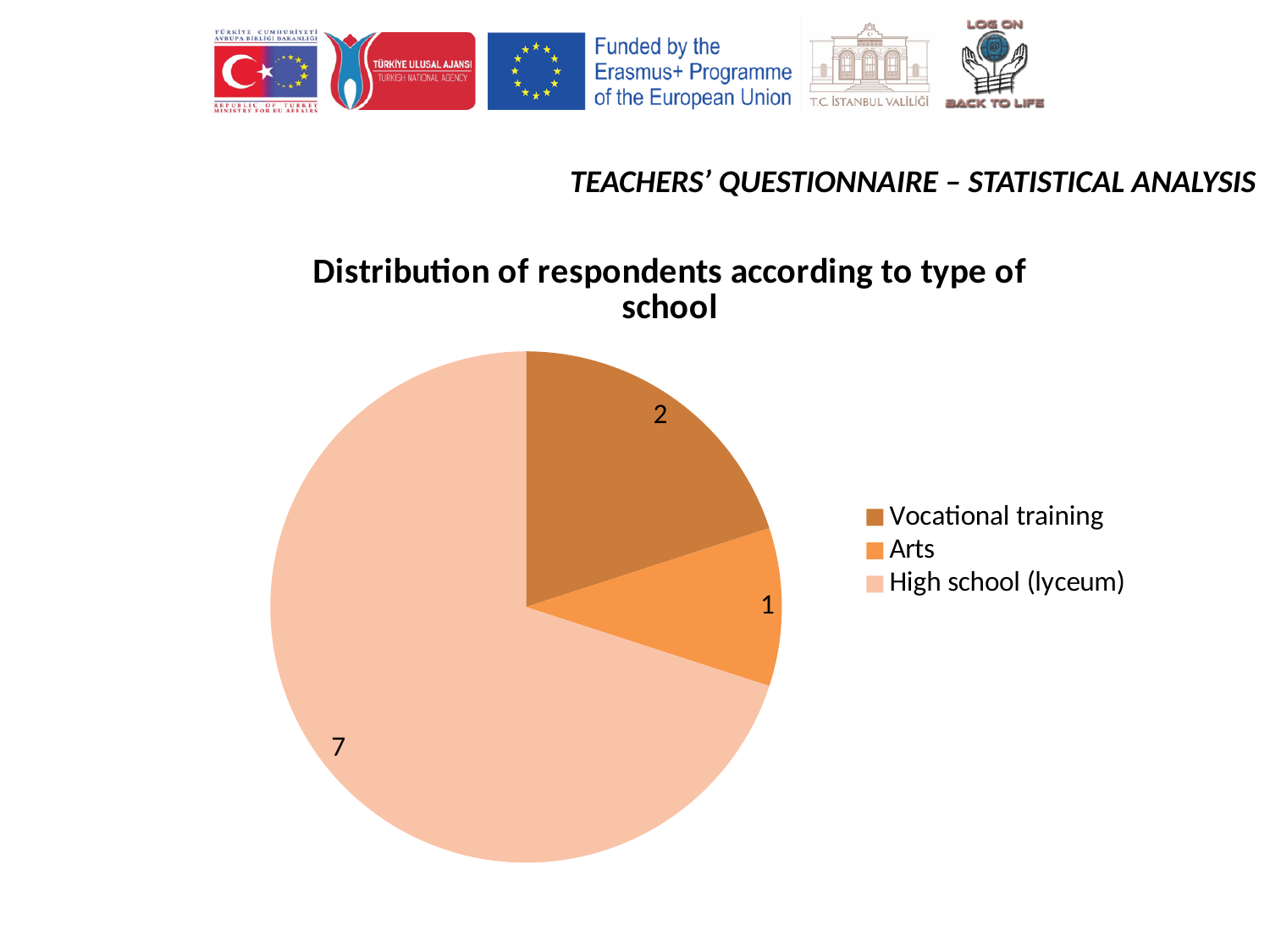
How many more respondents are from high school (lyceum) than from vocational training? 5 What is the total number of respondents shown in the pie chart? 10 How many categories does the pie chart show? 3 How many respondents are from high school (lyceum)? 7 What is the title of the chart? Distribution of respondents according to type of school What type of chart is shown on the slide? pie chart Which type of school has the most respondents? High school (lyceum) Which type of school has the fewest respondents? Arts How many respondents are from vocational training schools? 2 How many respondents are from arts schools? 1 What share of respondents are from high school (lyceum)? 70% Which has more respondents, vocational training or arts? Vocational training